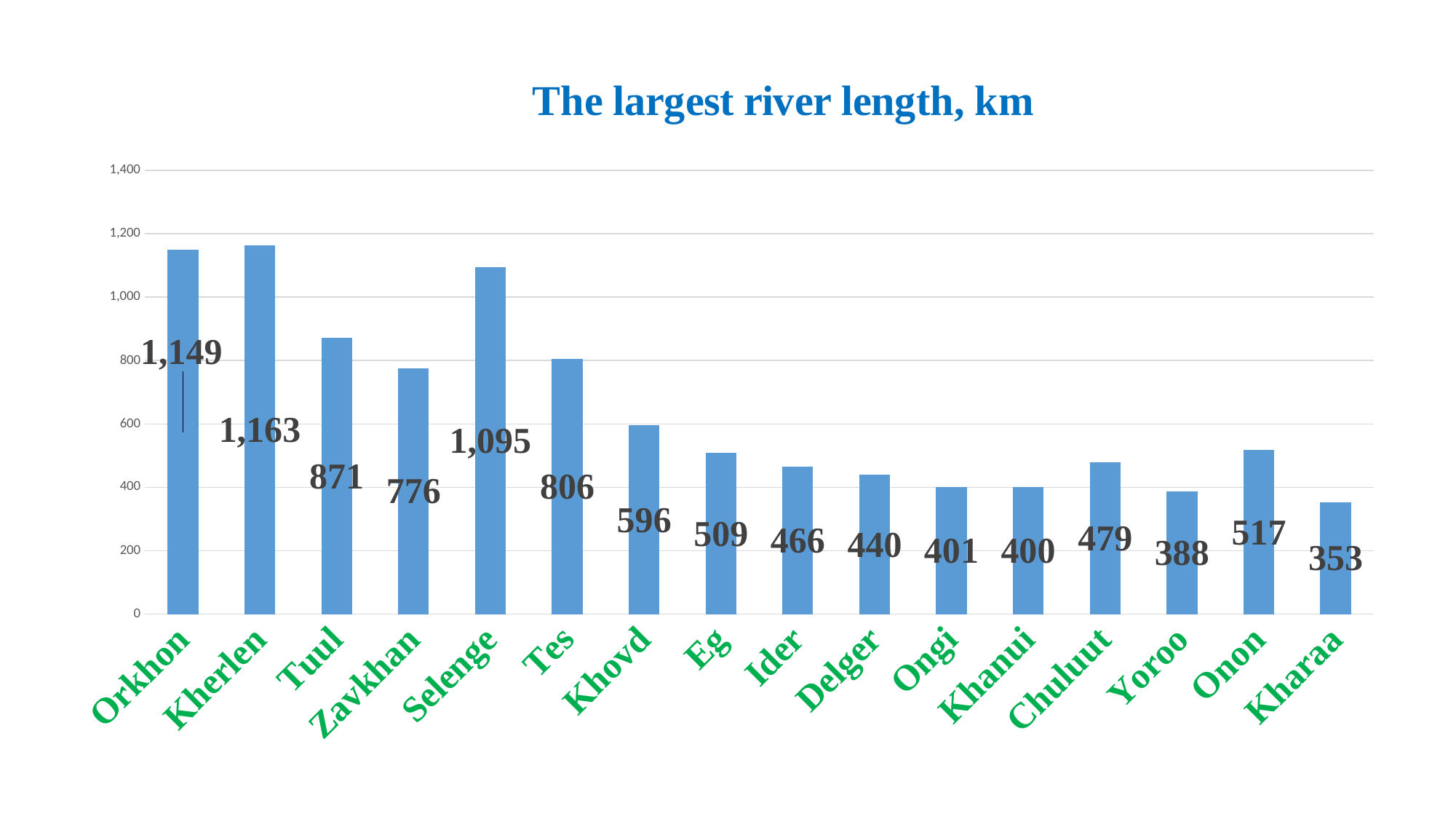
Which river has the greatest length? Kherlen What is the length of the Kharaa river? 353 Which river is longer, Onon or Eg? Onon What is the length of the Khovd river? 596 What is the difference in length between the Kherlen and Orkhon rivers? 14 How many rivers are shown in the chart? 16 What is the length of the Selenge river? 1,095 What is the length of the Kherlen river? 1,163 Which river has the smallest length? Kharaa What kind of chart is shown on the slide? Bar chart What is the difference in length between the Tuul and Zavkhan rivers? 95 What is the title of the chart? The largest river length, km